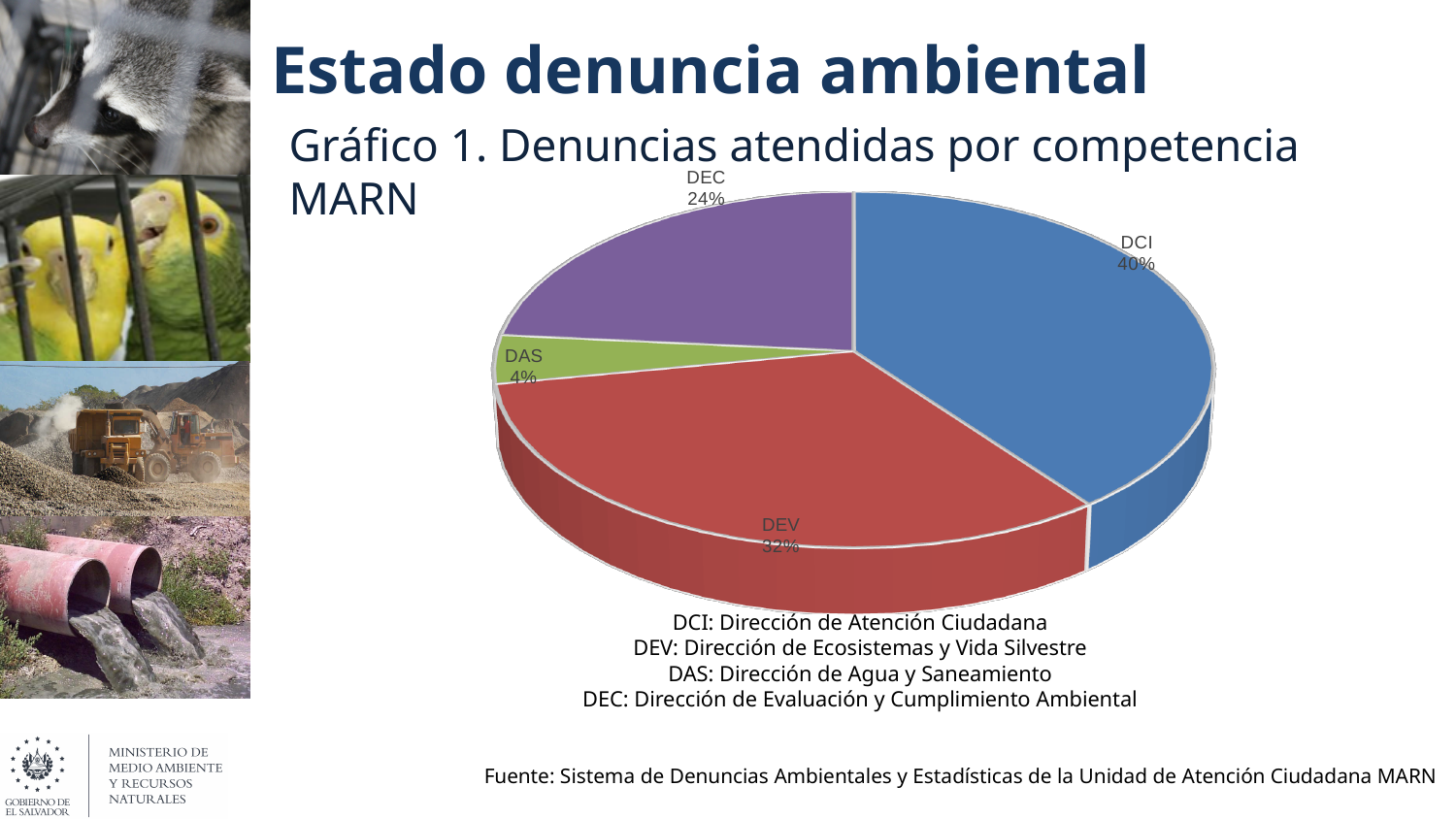
What percentage of the pie does DEC represent? 24% What percentage of the pie does DEV represent? 32% What type of chart is shown on the slide? pie chart Which category has the smallest share of the pie? DAS Which is larger, the share for DEC or the share for DEV? DEV What is the combined share of DCI and DEV? 72% Which category has the largest share of the pie? DCI What is the difference in percentage points between DCI and DEV? 8 What percentage of the pie does DCI represent? 40% How many slices does the pie chart have? 4 What percentage of the pie does DAS represent? 4% According to the slide, what does DAS stand for? Dirección de Agua y Saneamiento